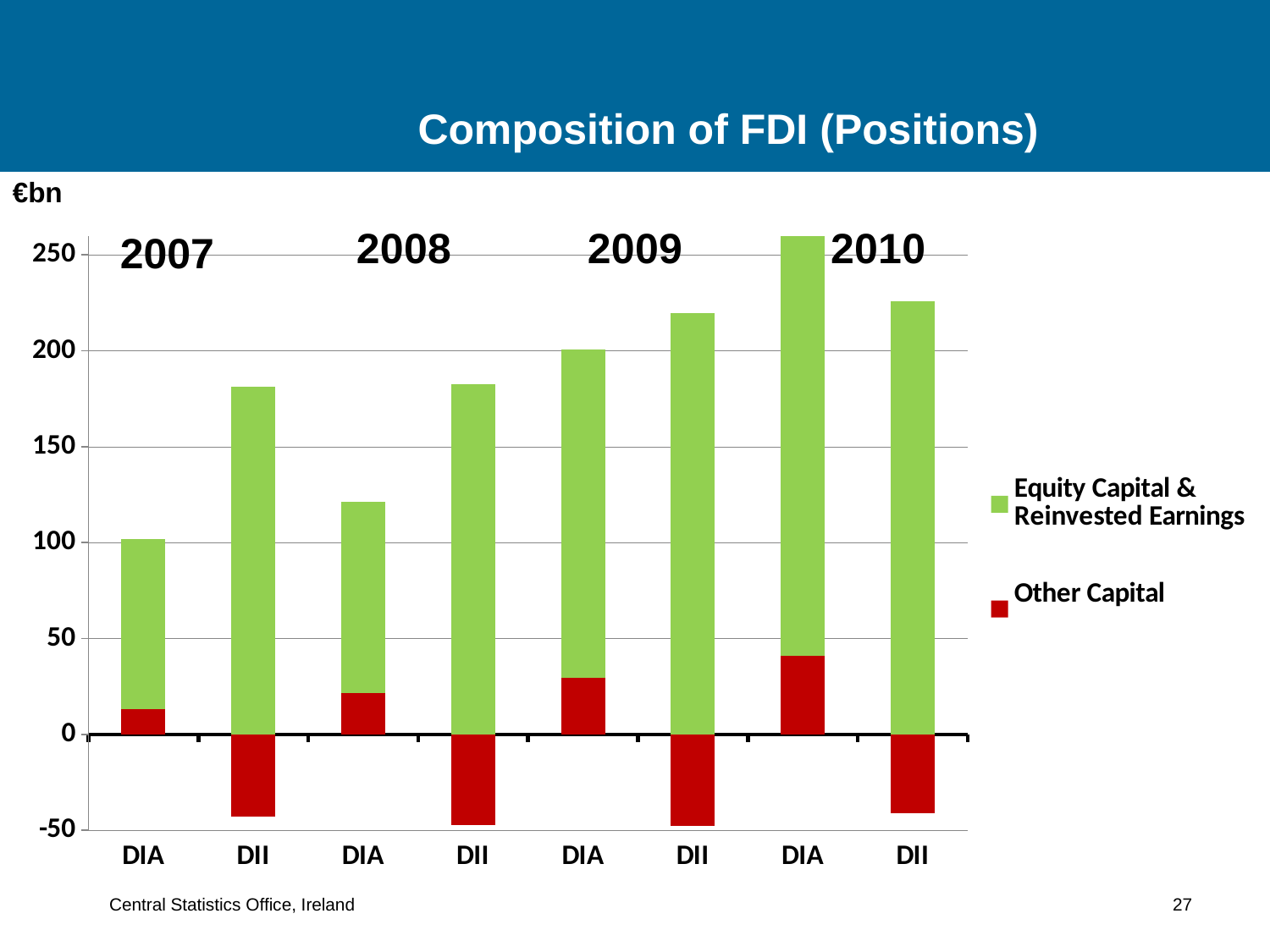
Is the Other Capital value for 2007 DII greater or less than 0? less Which bar reaches the highest value on the chart? 2010 DIA Is the top of the 2007 DII bar greater or less than 200? less Which colour represents Other Capital in the chart? Red Which bar is taller, 2007 DIA or 2007 DII? 2007 DII Do the DIA bars rise or fall from 2007 to 2010? Rise Which bar has the lowest top value for Equity Capital & Reinvested Earnings? 2007 DIA How many series does the legend list? 2 What kind of chart is shown on the slide? Bar chart Is the top of the 2010 DIA bar greater or less than 250? greater How many bars are plotted in the chart? 8